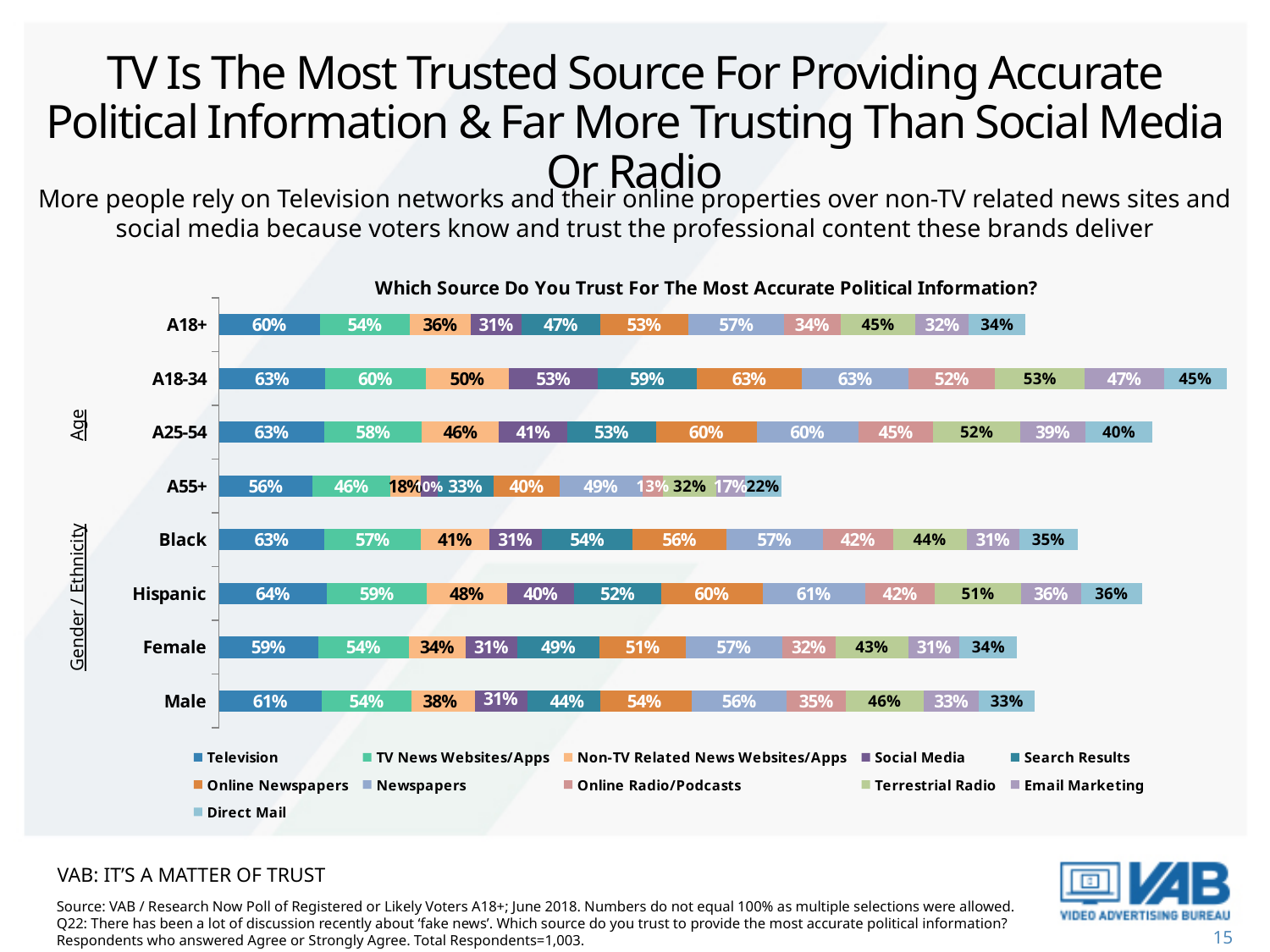
How many groups (bars) are shown on the chart? 8 What is the difference between the Television values for Male and Female? 2% Which is larger for the Black group: Television or Newspapers? Television What is the difference between the Search Results values for A18-34 and A55+? 26% What is the Social Media value for A55+? 10% What is the Television value for the Hispanic group? 64% What type of chart is shown? Stacked bar chart How many series does the legend list? 11 What is the Newspapers value for Female respondents? 57% Which group has the highest Television value? Hispanic Which group has the lowest Television value? A55+ What is the Direct Mail value for A18-34? 45%